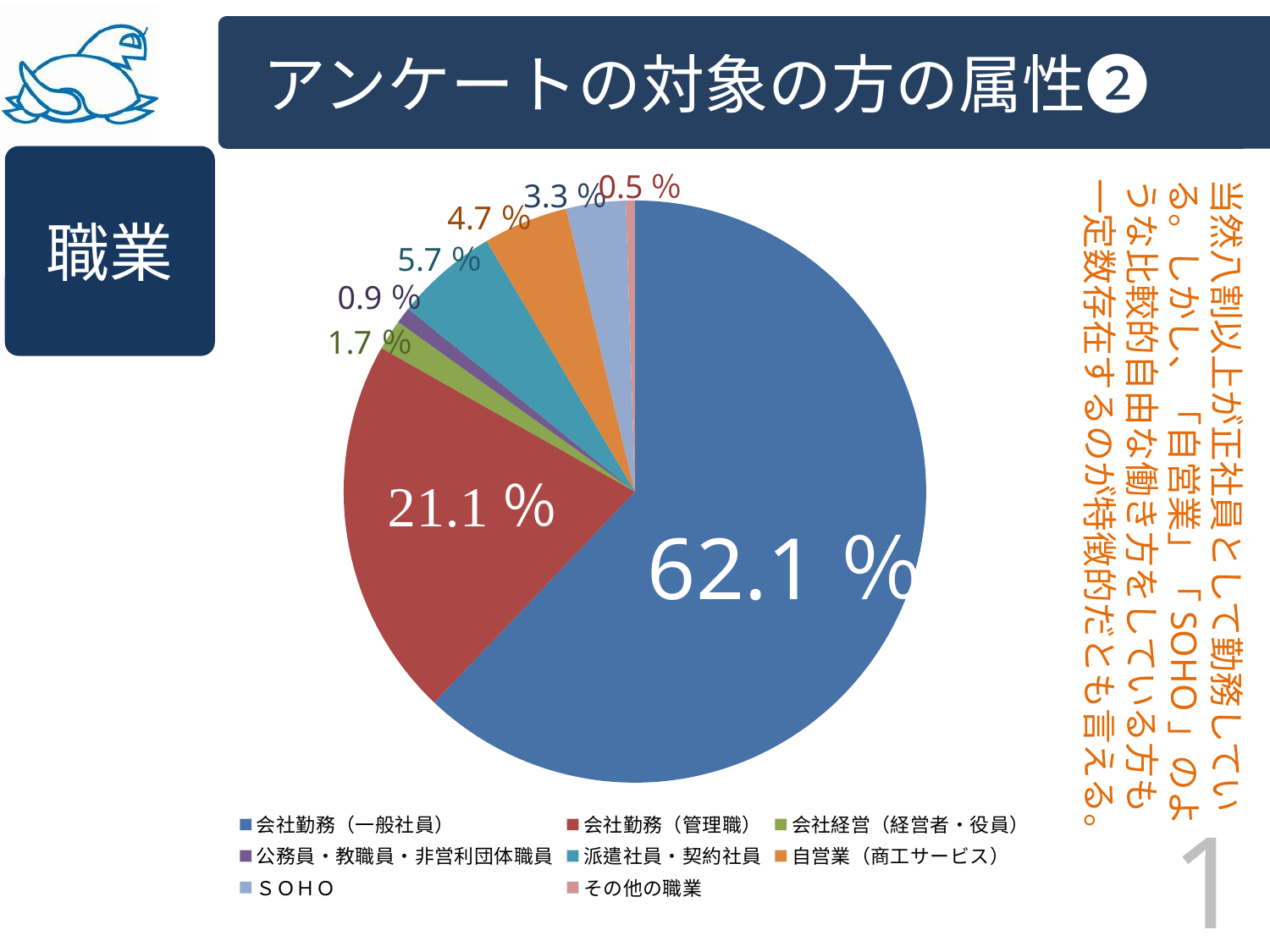
Which category has the largest slice of the pie? 会社勤務（一般社員） Which category has the smallest slice of the pie? その他の職業 What share of the pie is 公務員・教職員・非営利団体職員? 0.9 % What share of the pie is 自営業（商工サービス）? 4.7 % How many categories does the legend list? 8 What share of the pie is ＳＯＨＯ? 3.3 % What kind of chart is shown on the slide? pie chart What is the difference between the shares of 会社勤務（一般社員） and 会社勤務（管理職）? 41.0 % What share of the pie is 派遣社員・契約社員? 5.7 % What share of the pie is 会社勤務（一般社員）? 62.1 % What share of the pie is 会社勤務（管理職）? 21.1 % Which is larger, the share of 派遣社員・契約社員 or the share of 自営業（商工サービス）? 派遣社員・契約社員